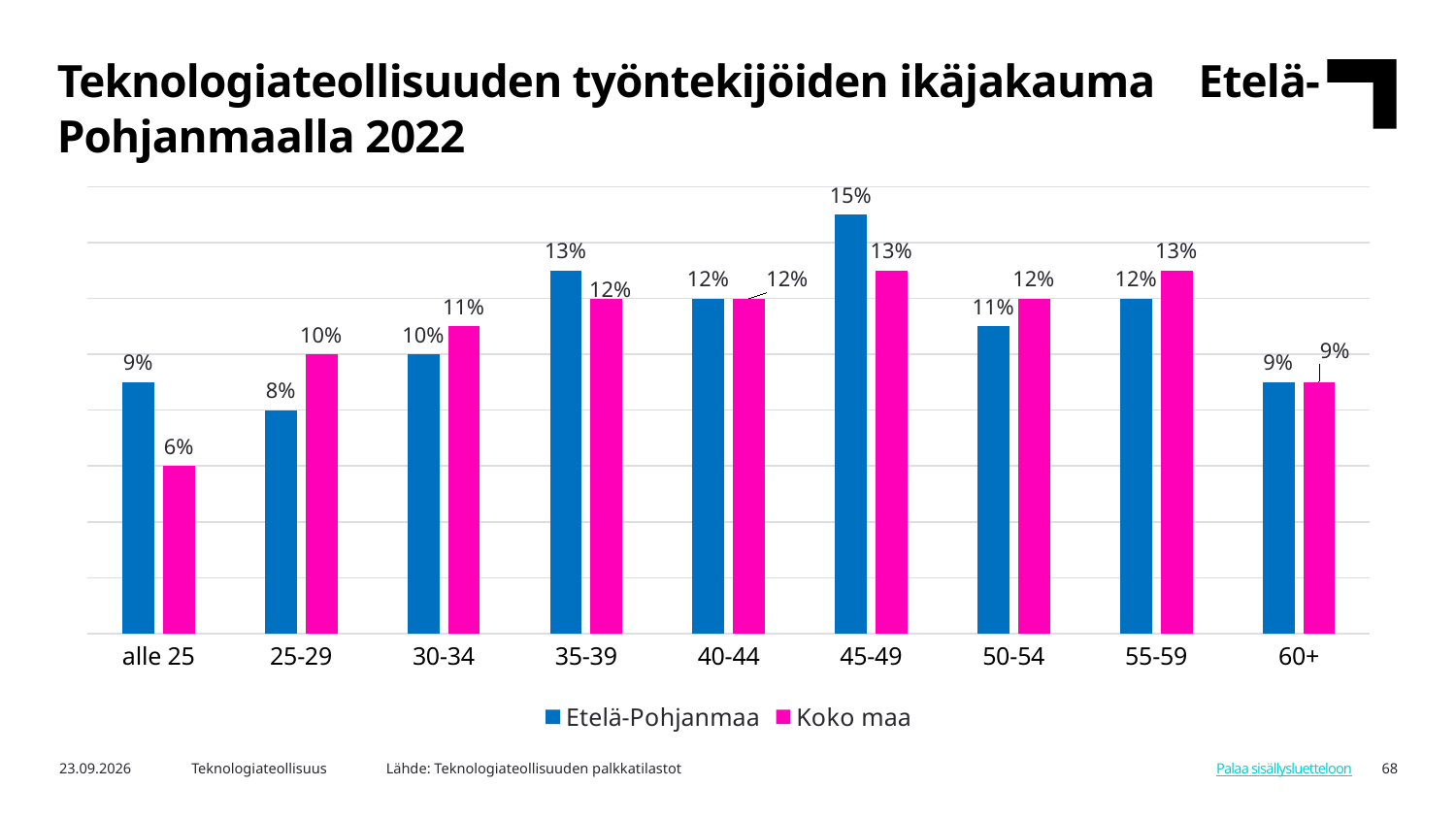
What is the value for Etelä-Pohjanmaa in the 45-49 age group? 15% What is the value for Koko maa in the 55-59 age group? 13% How many series does the legend list? 2 What kind of chart is shown on the slide? Bar chart Which age group has the highest value for Etelä-Pohjanmaa? 45-49 How many age groups are shown on the x axis? 9 In the alle 25 age group, which series has the larger value, Etelä-Pohjanmaa or Koko maa? Etelä-Pohjanmaa Which age group has the lowest value for Koko maa? alle 25 What is the value for Koko maa in the alle 25 age group? 6% Which age group has the lowest value for Etelä-Pohjanmaa? 25-29 What is the difference between the Etelä-Pohjanmaa and Koko maa values in the 45-49 age group? 2 percentage points What is the value for Etelä-Pohjanmaa in the 25-29 age group? 8%